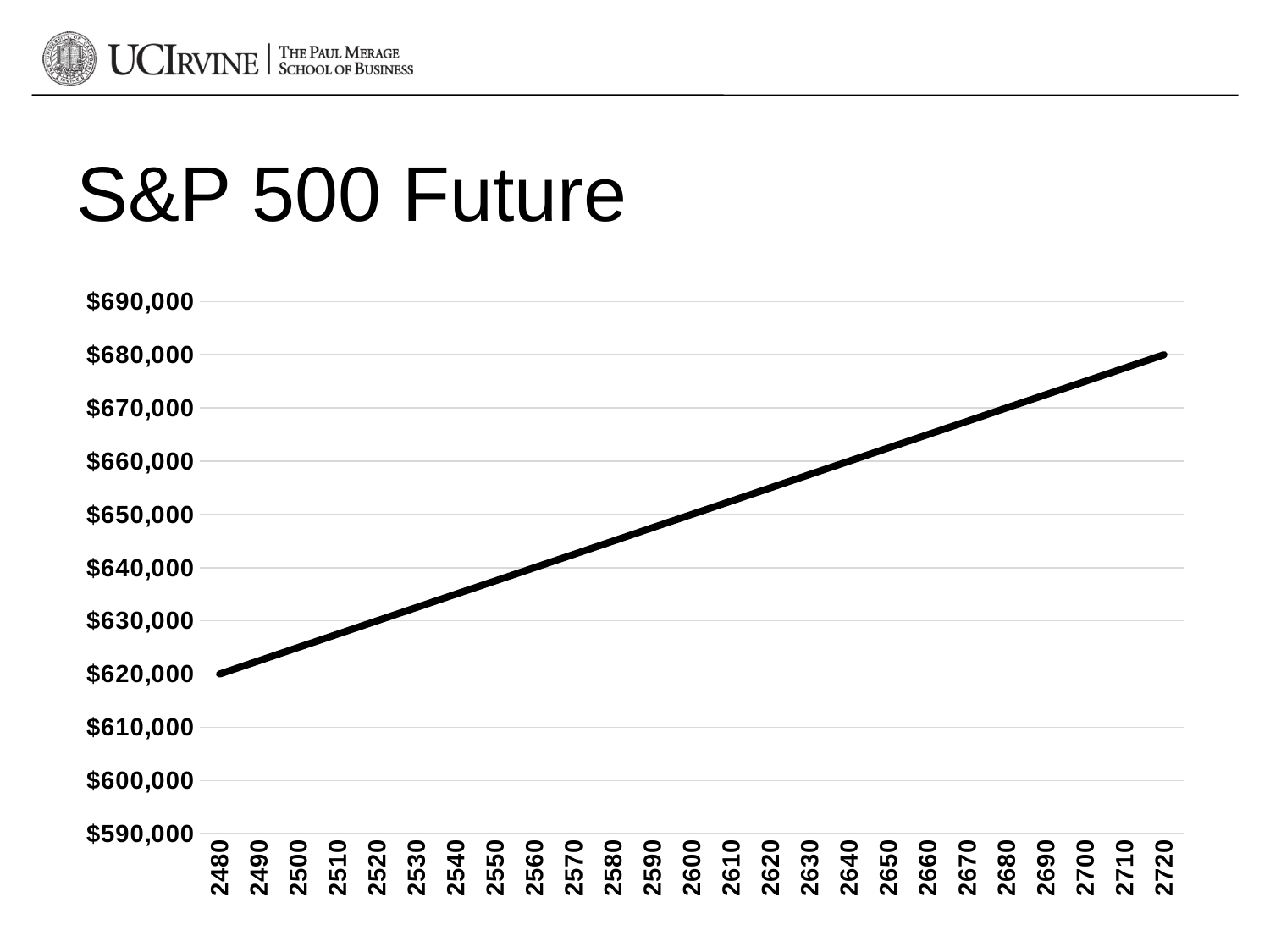
What is the value of the S&P 500 Future at an index level of 2480? $620,000 What kind of chart is shown on the slide? line chart What is the value of the S&P 500 Future at an index level of 2600? $650,000 At which index level on the x axis is the value lowest? 2480 Is the value at an index level of 2700 greater or less than $670,000? greater What is the title of the chart? S&P 500 Future At which index level on the x axis is the value highest? 2720 Does the value rise or fall as the index level increases along the x axis? rise Is the value at an index level of 2550 greater or less than $630,000? greater How many index levels are labelled on the x axis? 25 What is the value of the S&P 500 Future at an index level of 2720? $680,000 What is the difference between the value at 2720 and the value at 2480? $60,000